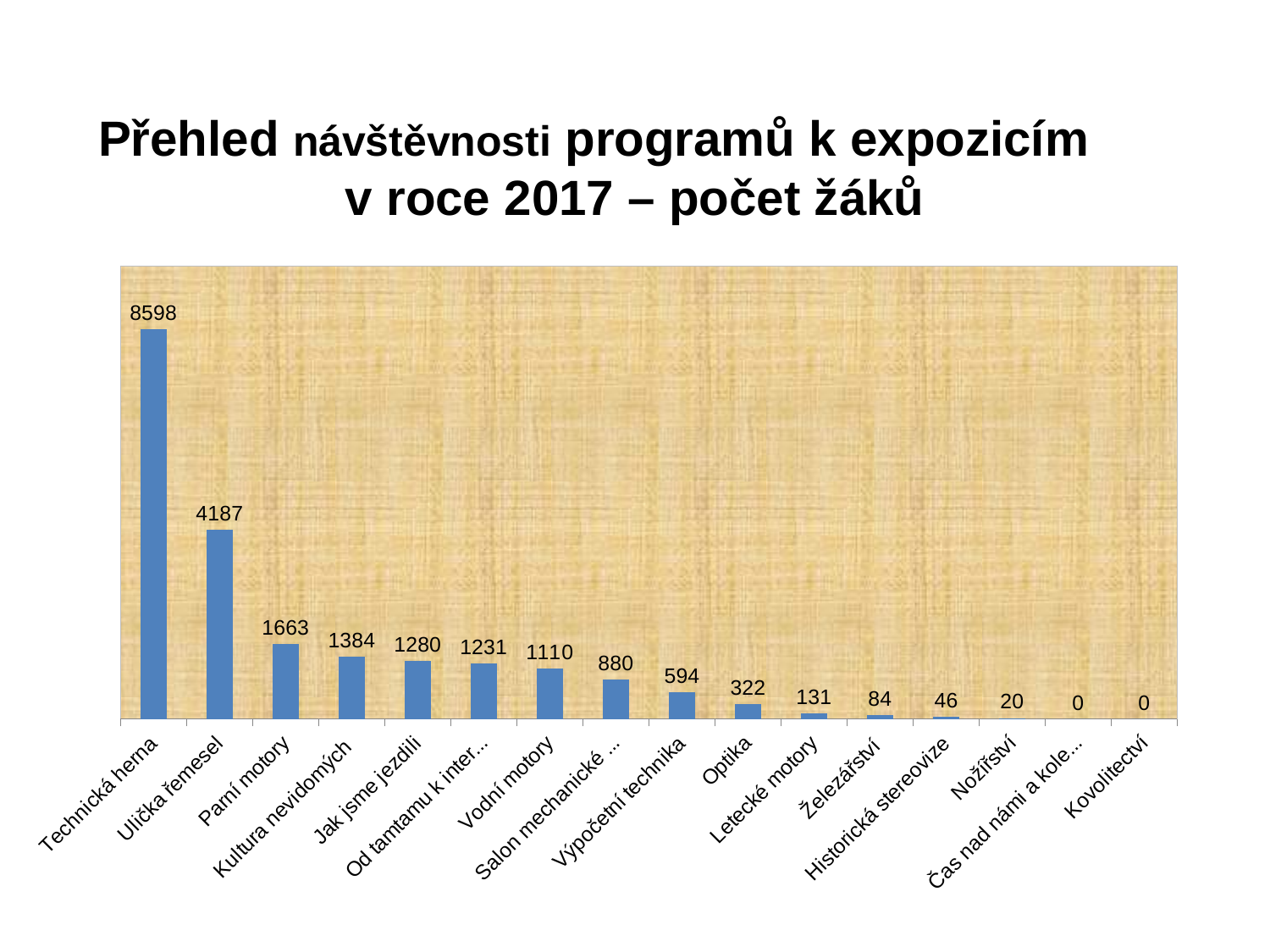
What is the value for Historická stereovize? 46 How many categories (programs) are plotted in the chart? 16 What is the difference between the values for Technická herna and Ulička řemesel? 4411 What is the value for Výpočetní technika? 594 Do the values rise or fall from left to right along the x axis? fall What is the value for Parní motory? 1663 Which is larger, the value for Optika or the value for Letecké motory? Optika What is the value for Ulička řemesel? 4187 Which category has the highest value? Technická herna What is the value for Technická herna? 8598 What kind of chart is shown on the slide? bar chart What is the difference between the values for Kultura nevidomých and Jak jsme jezdili? 104